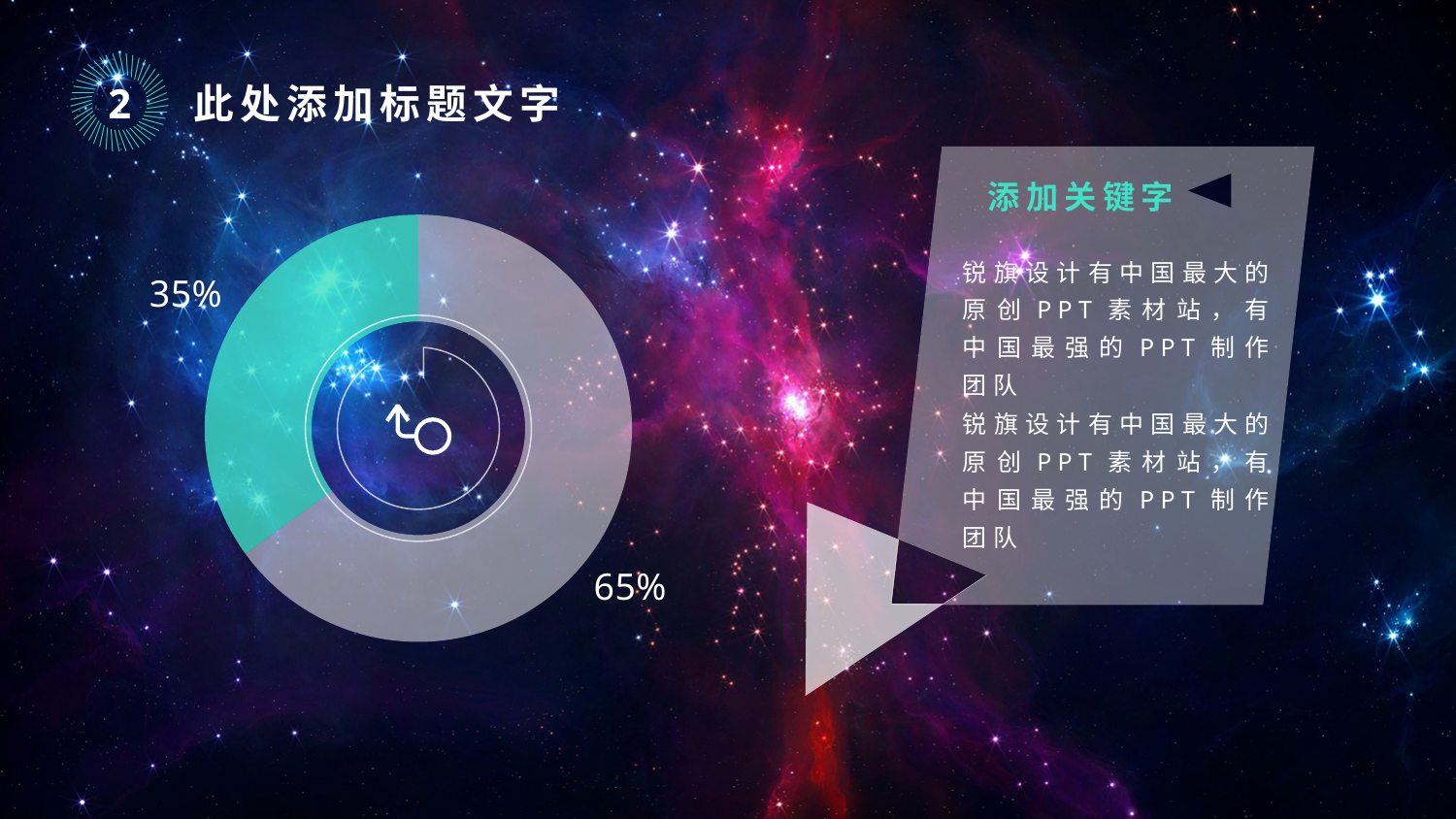
What colour is the slice labelled 35%? teal (green) Is the value of the grey slice greater or less than 50%? greater Which slice of the donut chart is the largest? the grey slice (65%) What value is labelled on the teal (green) slice of the donut chart? 35% What is the difference between the two slice values in the donut chart? 30% How many slices does the donut chart have? 2 Is the value of the teal slice greater or less than 50%? less What do the two slice values of the donut chart add up to? 100% Which is larger in the donut chart, the teal slice or the grey slice? the grey slice What value is labelled on the grey slice of the donut chart? 65% Which slice of the donut chart is the smallest? the teal slice (35%) What kind of chart is shown on the slide? pie chart (donut)